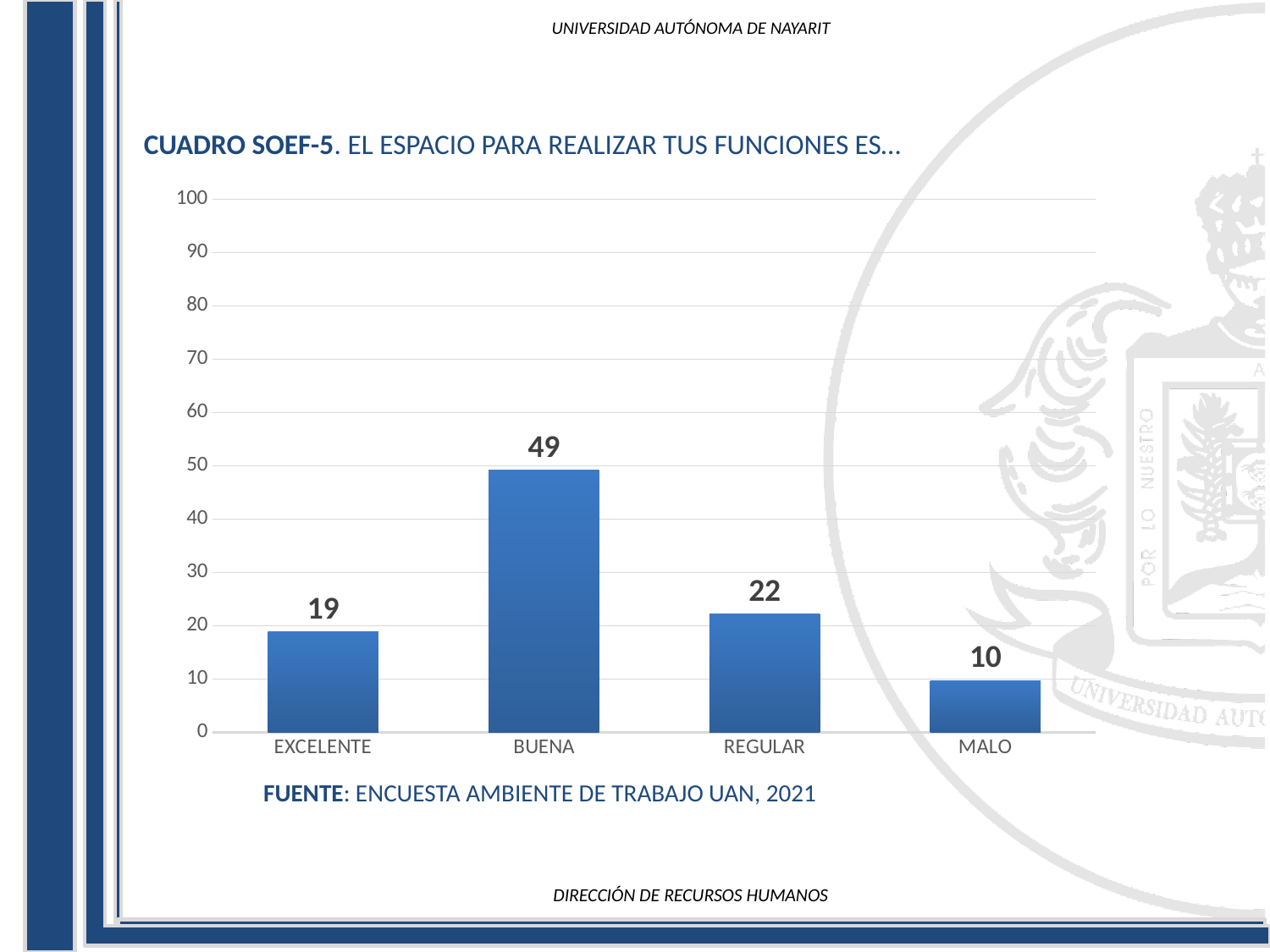
Which is larger, the value for EXCELENTE or the value for MALO? EXCELENTE What is the value for MALO? 10 What kind of chart is shown on the slide? bar chart What is the value for EXCELENTE? 19 Which category has the highest value? BUENA What is the value for BUENA? 49 Is the value for BUENA greater or less than 40? greater What is the value for REGULAR? 22 What is the difference between the values for REGULAR and EXCELENTE? 3 Which category has the lowest value? MALO How many categories are shown on the x axis? 4 What is the difference between the values for BUENA and REGULAR? 27